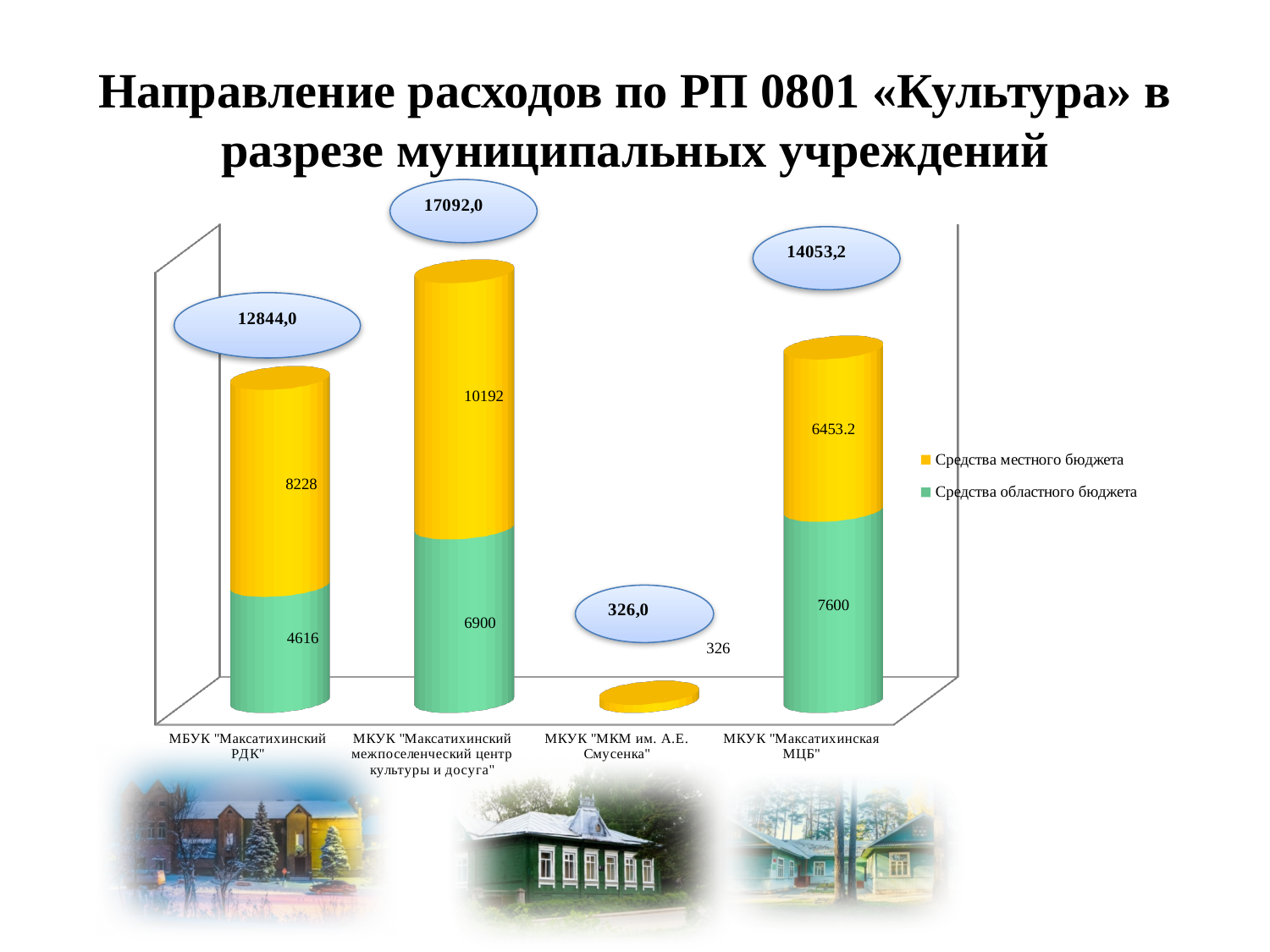
How many series does the legend list? 2 Which institution has the lowest total expenditure? МКУК "МКМ им. А.Е. Смусенка" For МКУК "Максатихинская МЦБ", which is larger: "Средства местного бюджета" or "Средства областного бюджета"? Средства областного бюджета What is the difference between the "Средства местного бюджета" values for МКУК "Максатихинский межпоселенческий центр культуры и досуга" and МБУК "Максатихинский РДК"? 1964 What is the value of "Средства местного бюджета" for МБУК "Максатихинский РДК"? 8228 Which institution has the highest total expenditure? МКУК "Максатихинский межпоселенческий центр культуры и досуга" What is the value of "Средства областного бюджета" for МКУК "Максатихинский межпоселенческий центр культуры и досуга"? 6900 What is the value of "Средства местного бюджета" for МКУК "Максатихинская МЦБ"? 6453.2 Which colour represents "Средства областного бюджета" in the chart? Green What total is shown in the callout above the bar for МКУК "МКМ им. А.Е. Смусенка"? 326,0 What type of chart is shown on the slide? Bar chart (stacked) How many institutions (categories) are shown on the x axis? 4